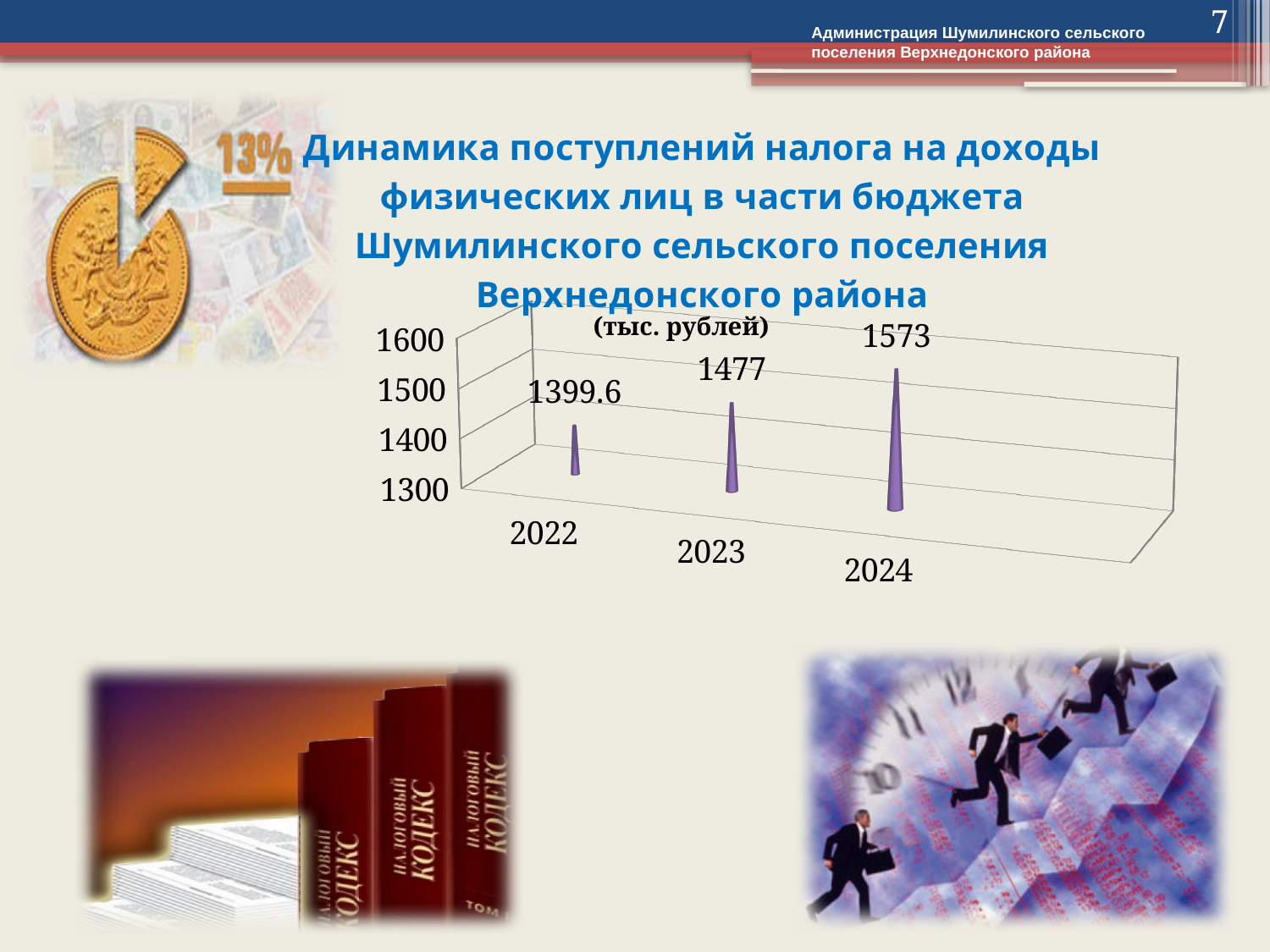
Do the values rise or fall from 2022 to 2024? rise Is the value for 2024 greater or less than 1500? greater Which is larger, the value for 2022 or the value for 2024? 2024 Which year has the highest value? 2024 What is the value for 2023? 1477 What is the value for 2022? 1399.6 In what units are the chart values given, according to the label above the chart? тыс. рублей What is the difference between the values for 2024 and 2023? 96 What is the value for 2024? 1573 How many years are shown on the chart? 3 What is the difference between the values for 2023 and 2022? 77.4 Which year has the lowest value? 2022